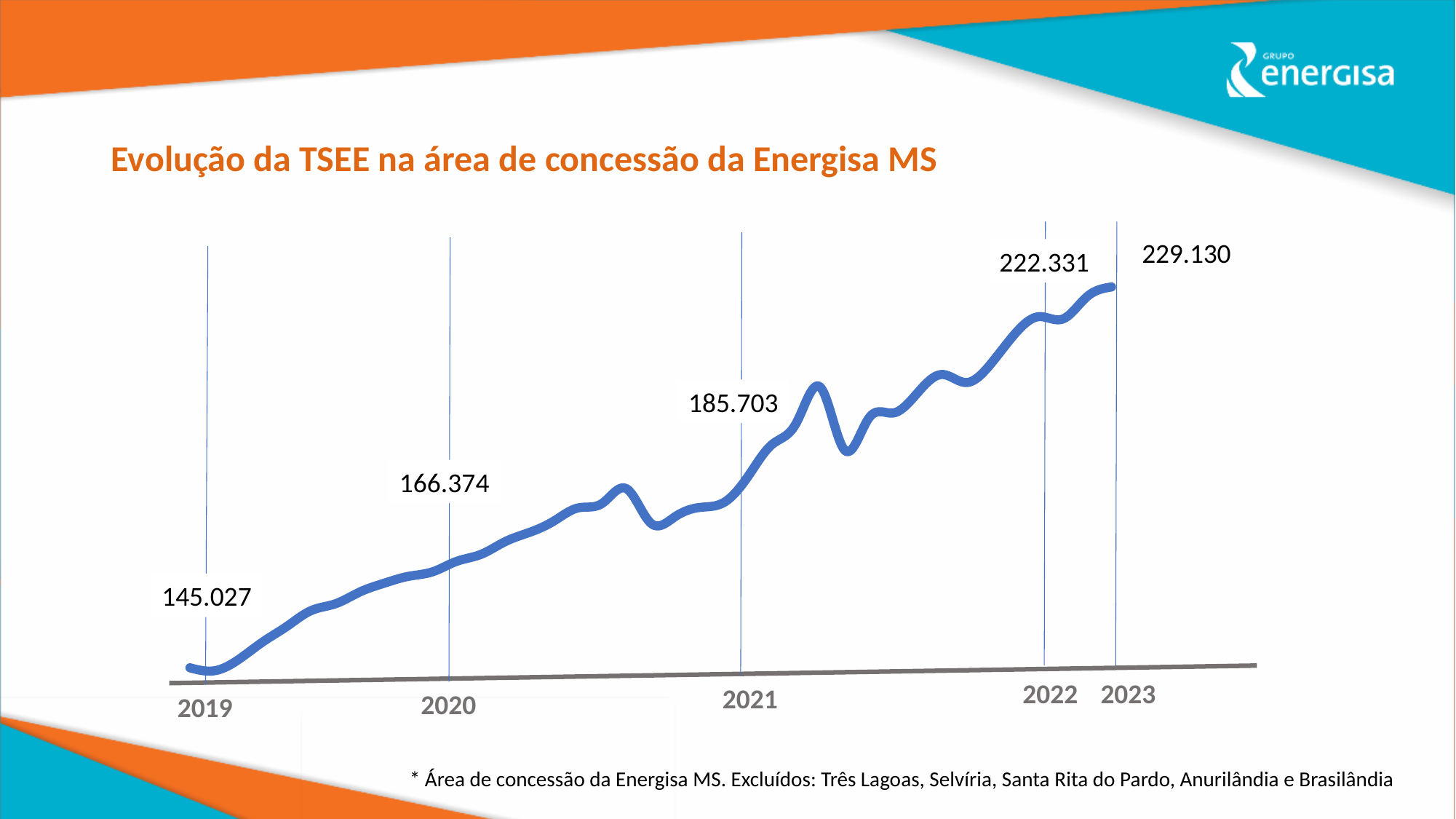
Which year has the highest labelled value? 2023 What is the value labelled for 2021? 185.703 Do the labelled values rise or fall from 2019 to 2023? rise What is the value labelled for 2023? 229.130 Which year has the lowest labelled value? 2019 What is the difference between the labelled values for 2023 and 2022? 6.799 What is the value labelled for 2022? 222.331 What is the difference between the labelled values for 2022 and 2021? 36.628 What is the value labelled for 2019? 145.027 What type of chart is shown on the slide? line chart What is the value labelled for 2020? 166.374 What is the title of the chart? Evolução da TSEE na área de concessão da Energisa MS